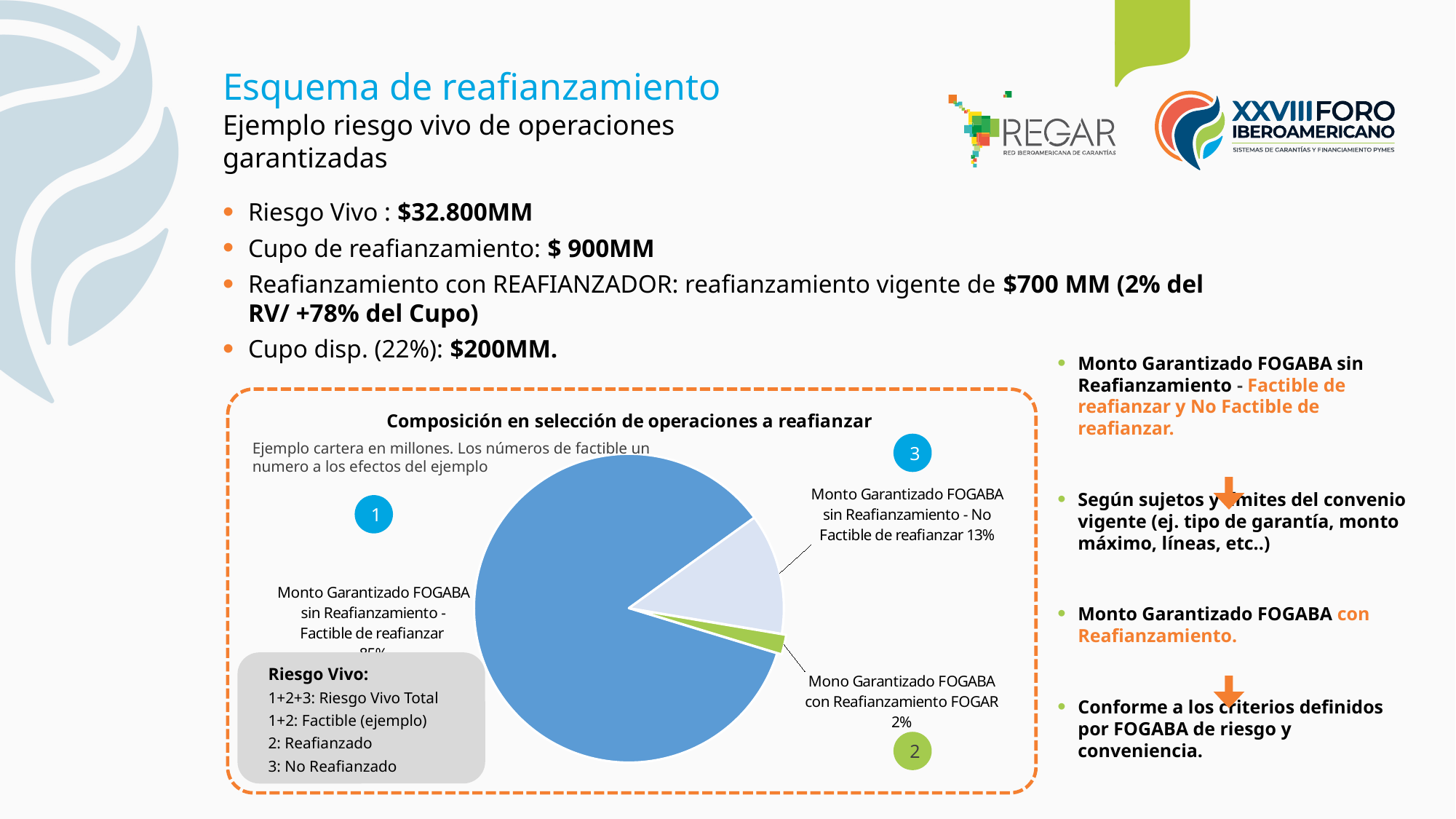
Which slice of the pie chart is the smallest? Mono Garantizado FOGABA con Reafianzamiento FOGAR What is the title of the chart? Composición en selección de operaciones a reafianzar What is the difference in percentage points between the 'No Factible de reafianzar' slice and the 'con Reafianzamiento FOGAR' slice? 11 percentage points How many slices does the pie chart have? 3 Which slice of the pie chart is the largest? Monto Garantizado FOGABA sin Reafianzamiento - Factible de reafianzar Which is larger: the 'No Factible de reafianzar' slice or the 'con Reafianzamiento FOGAR' slice? No Factible de reafianzar What colour is the 'Mono Garantizado FOGABA con Reafianzamiento FOGAR' slice? Green What share of the pie is 'Monto Garantizado FOGABA sin Reafianzamiento - No Factible de reafianzar'? 13% What percentage is shown for 'Mono Garantizado FOGABA con Reafianzamiento FOGAR'? 2% What kind of chart is shown on the slide? Pie chart